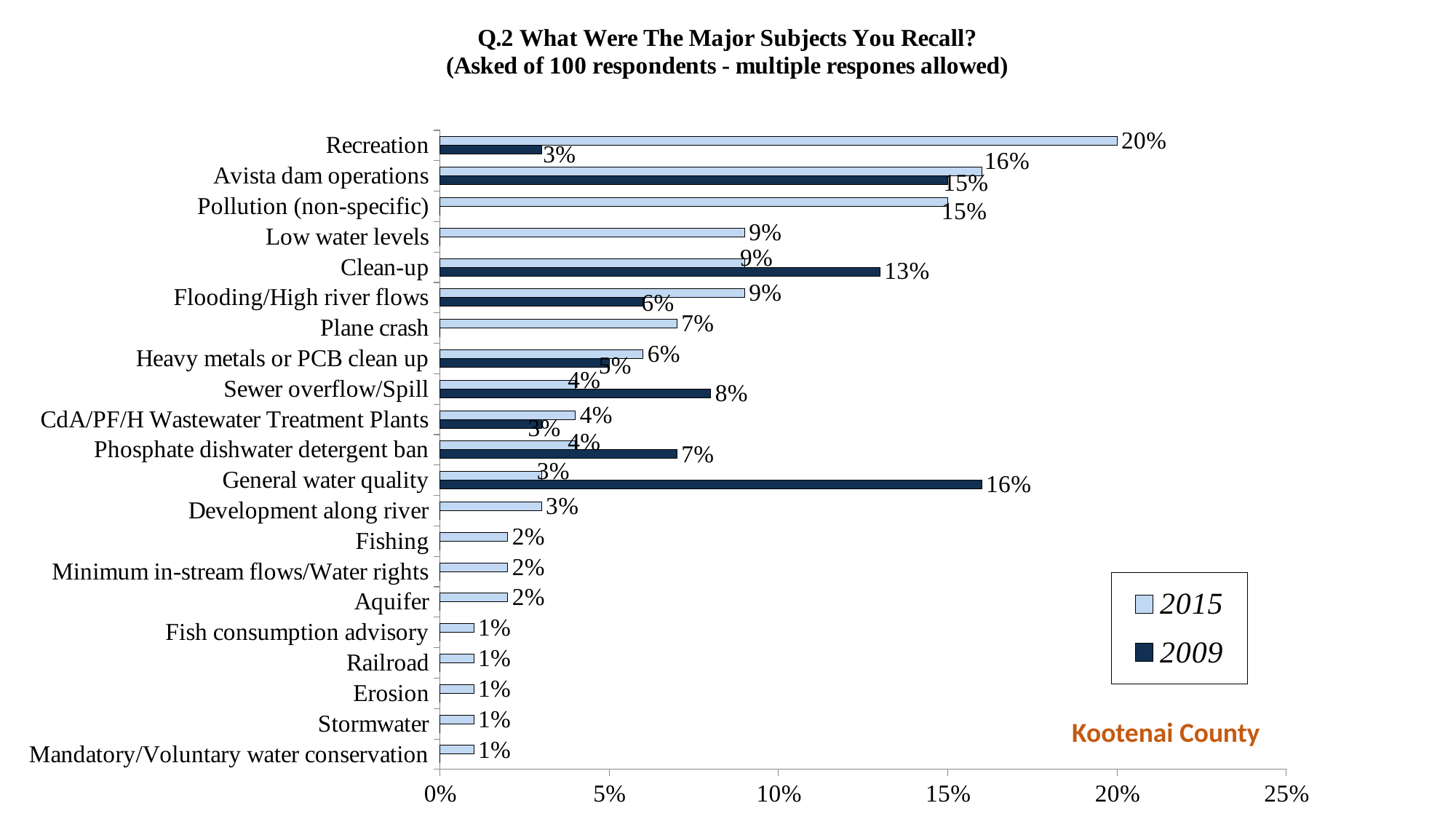
Is the 2015 value for Avista dam operations greater or less than 15%? greater How many categories are listed on the chart? 21 What is the 2015 value for Plane crash? 7% What type of chart is shown on the slide? Bar chart Which category has the highest 2015 value? Recreation How many series does the legend list? 2 What is the 2009 value for Clean-up? 13% What is the 2015 value for Recreation? 20% For Sewer overflow/Spill, which year has the larger value, 2015 or 2009? 2009 Which category has the highest 2009 value? General water quality What is the difference between the 2015 and 2009 values for Recreation? 17 percentage points What is the 2009 value for General water quality? 16%